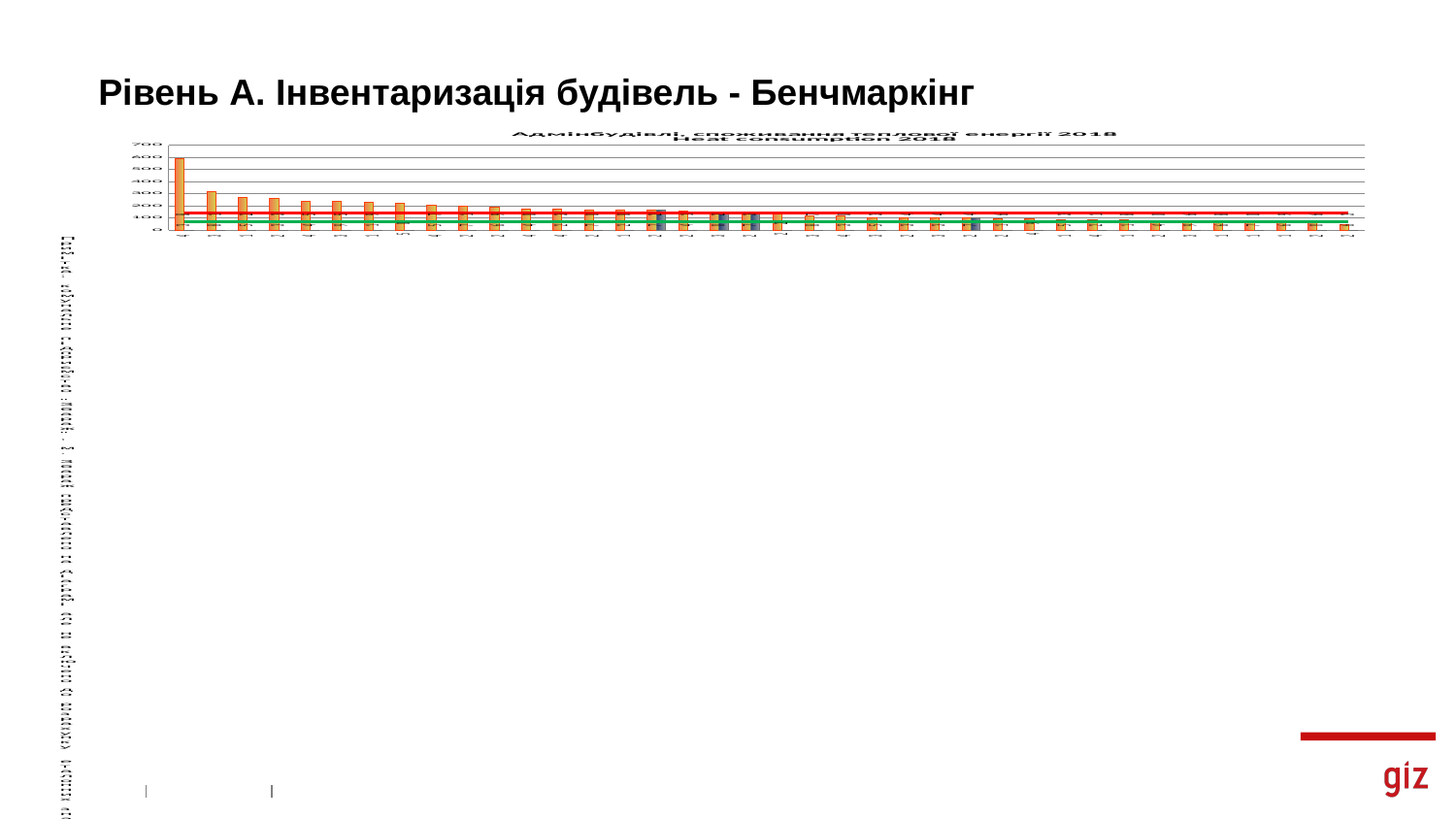
What is the highest value shown on the chart's vertical axis? 700 What is the English title printed above the chart? Heat consumption 2018 Which bar is the tallest on the chart, the leftmost or the rightmost? the leftmost Do the bar values rise or fall moving from left to right along the x axis? fall Is the value of the leftmost (tallest) bar greater or less than 400? greater What kind of chart is shown on the slide? combination bar and line chart Is the value of the second bar from the left greater or less than 200? greater Is the level of the red horizontal line greater or less than 200? less